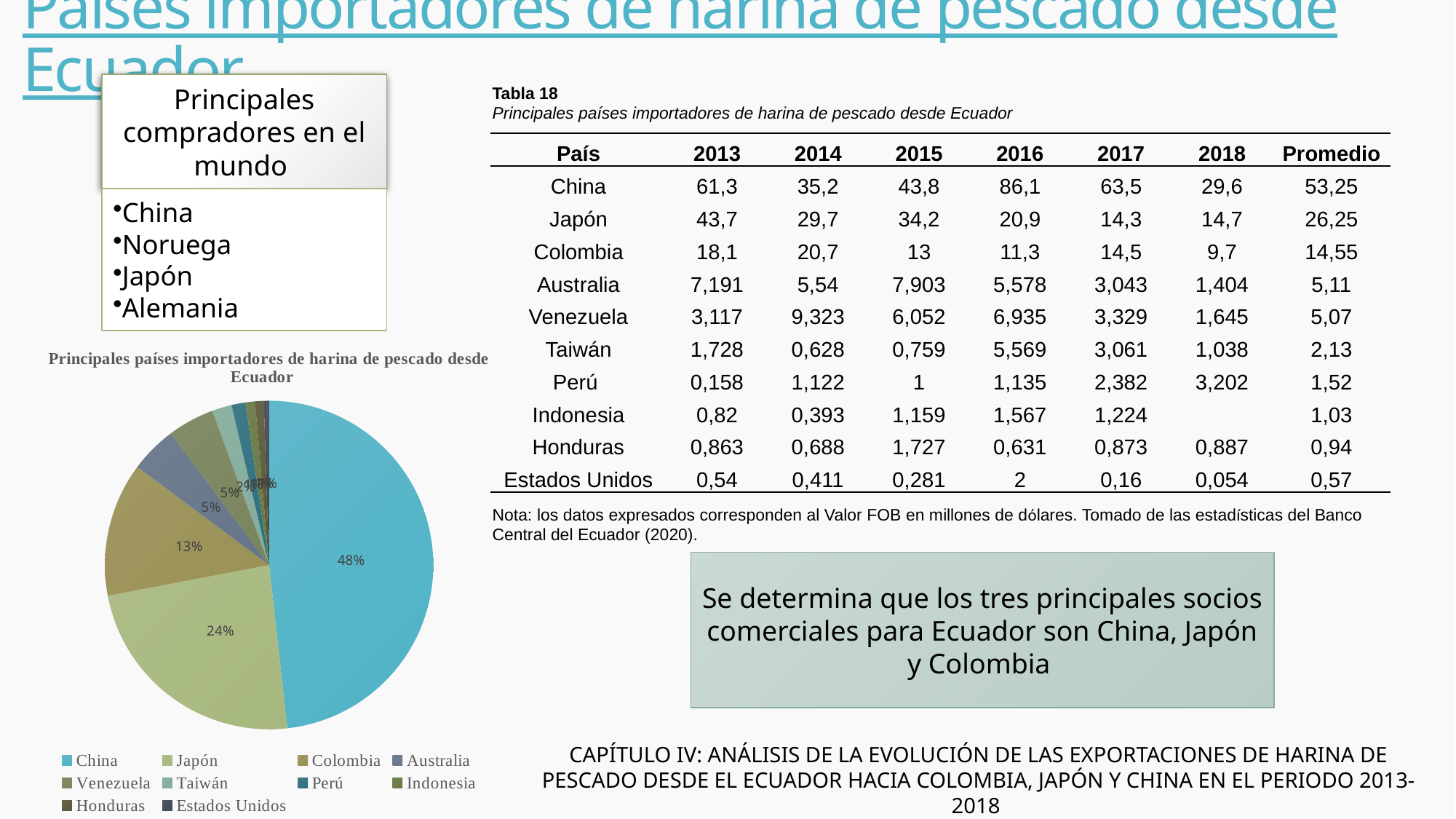
What kind of chart is shown on the slide? pie chart What is the title of the pie chart? Principales países importadores de harina de pescado desde Ecuador What share of the pie does China account for? 48% What share of the pie does Venezuela account for? 5% By how many percentage points does China's share exceed Japón's share in the pie chart? 24 What share of the pie does Japón account for? 24% How many countries does the pie chart's legend list? 10 Which country has the largest slice of the pie chart? China How many slices does the pie chart have? 10 Which slice is larger in the pie chart, Japón or Colombia? Japón